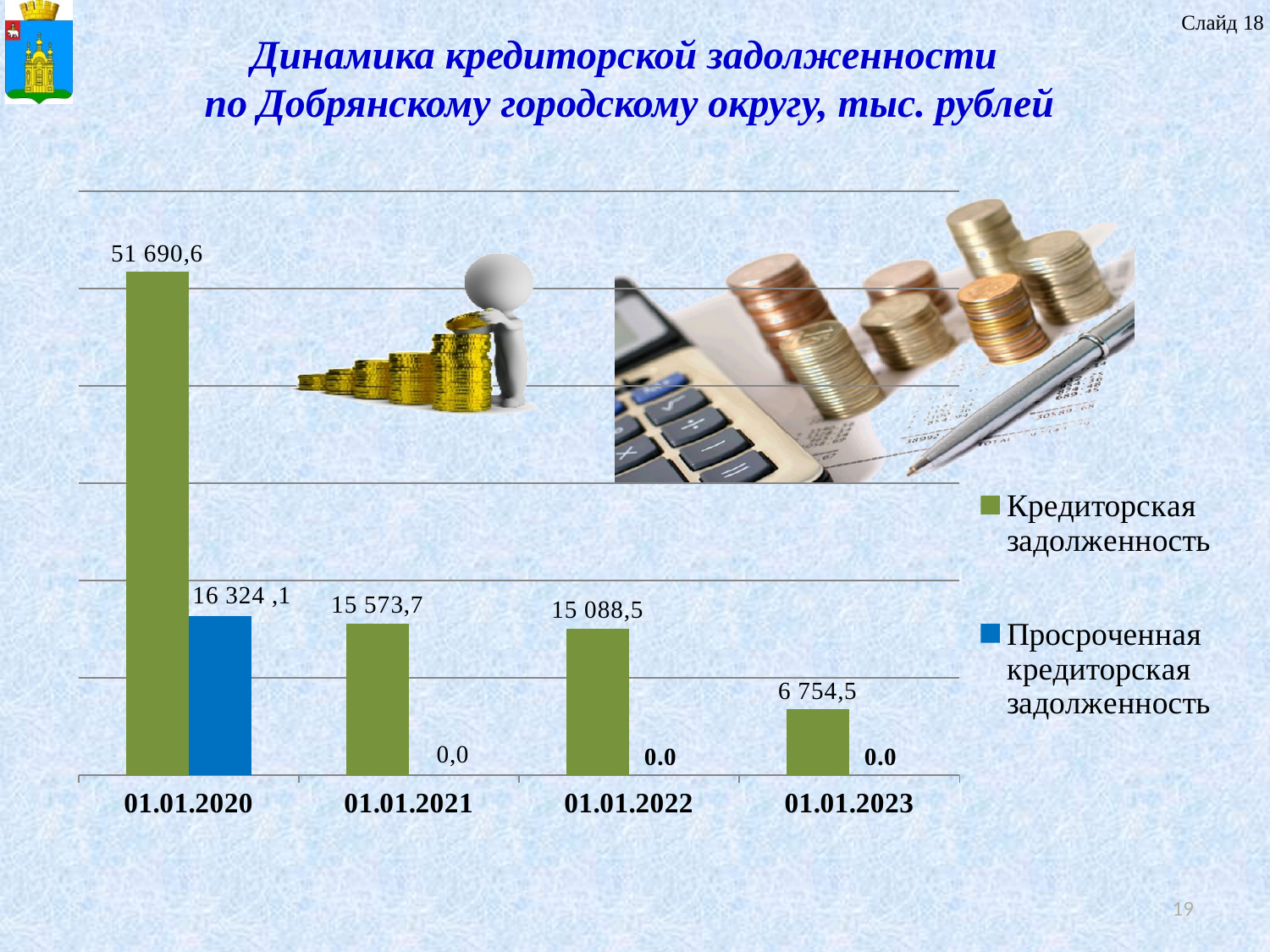
What is the difference between Кредиторская задолженность on 01.01.2020 and on 01.01.2023? 44 936,1 What is the difference between Кредиторская задолженность on 01.01.2021 and on 01.01.2022? 485,2 On which date is Кредиторская задолженность lowest? 01.01.2023 On which date is Кредиторская задолженность highest? 01.01.2020 How many series does the legend list? 2 What is the value of Кредиторская задолженность on 01.01.2023? 6 754,5 What is the value of Просроченная кредиторская задолженность on 01.01.2020? 16 324,1 What is the value of Кредиторская задолженность on 01.01.2020? 51 690,6 Does Кредиторская задолженность rise or fall from 01.01.2020 to 01.01.2023? fall Which is larger: Кредиторская задолженность on 01.01.2021 or on 01.01.2022? 01.01.2021 What is the value of Просроченная кредиторская задолженность on 01.01.2022? 0.0 How many dates are shown on the x axis? 4